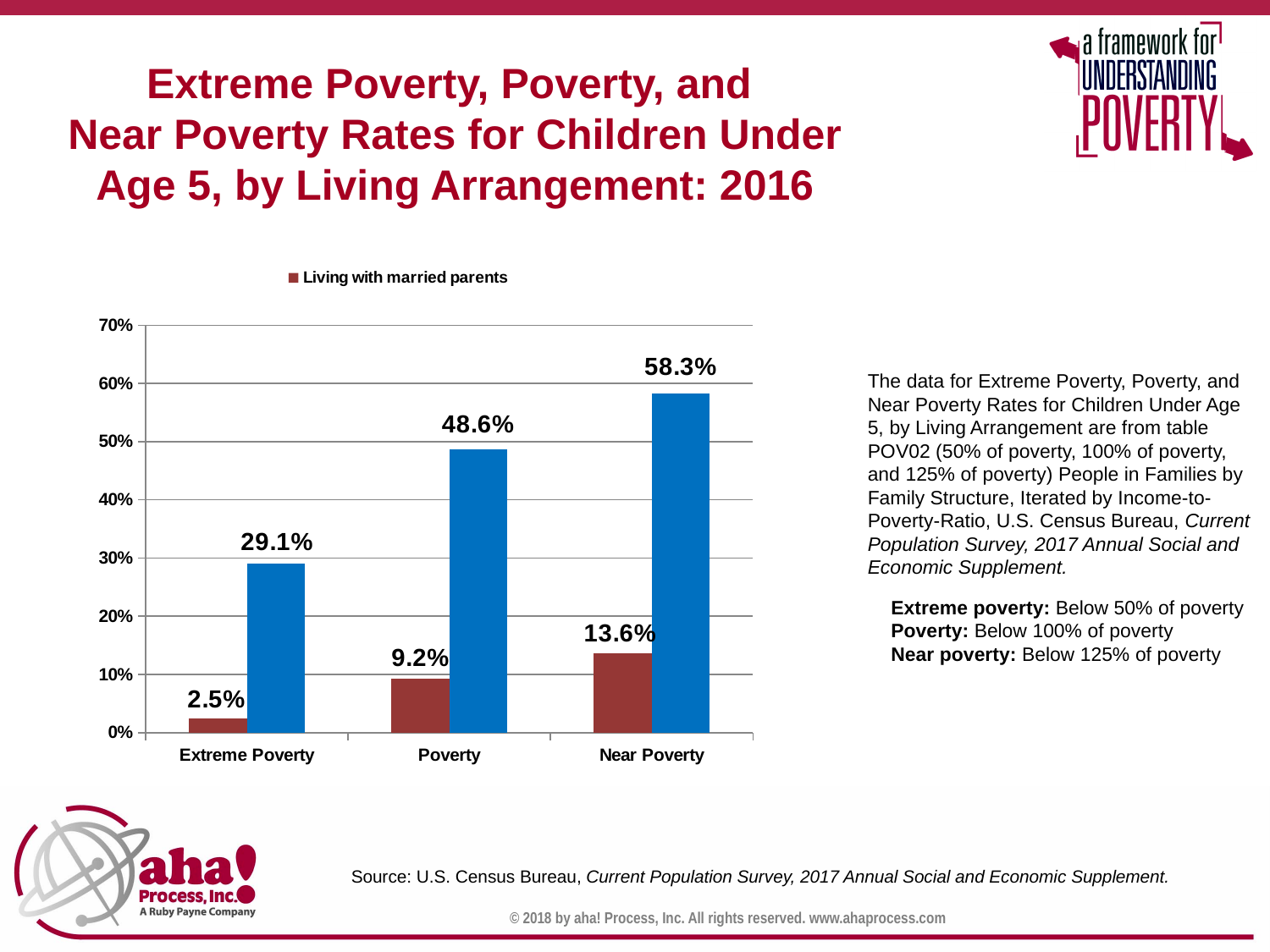
Which is larger for Living with married parents: Poverty or Extreme Poverty? Poverty Do the Living with married parents values rise or fall from Extreme Poverty to Near Poverty? Rise What is the value for Living with married parents in the Extreme Poverty category? 2.5% Is the value for Living with married parents in the Near Poverty category greater or less than 10%? greater What is the value for Living with married parents in the Poverty category? 9.2% What is the difference between the Living with married parents values for Near Poverty and Poverty? 4.4% What is the difference between the Living with married parents values for Poverty and Extreme Poverty? 6.7% How many categories are shown on the x axis? 3 Which category has the lowest value for Living with married parents? Extreme Poverty What is the value for Living with married parents in the Near Poverty category? 13.6% What kind of chart is shown on the slide? Bar chart Which category has the highest value for Living with married parents? Near Poverty